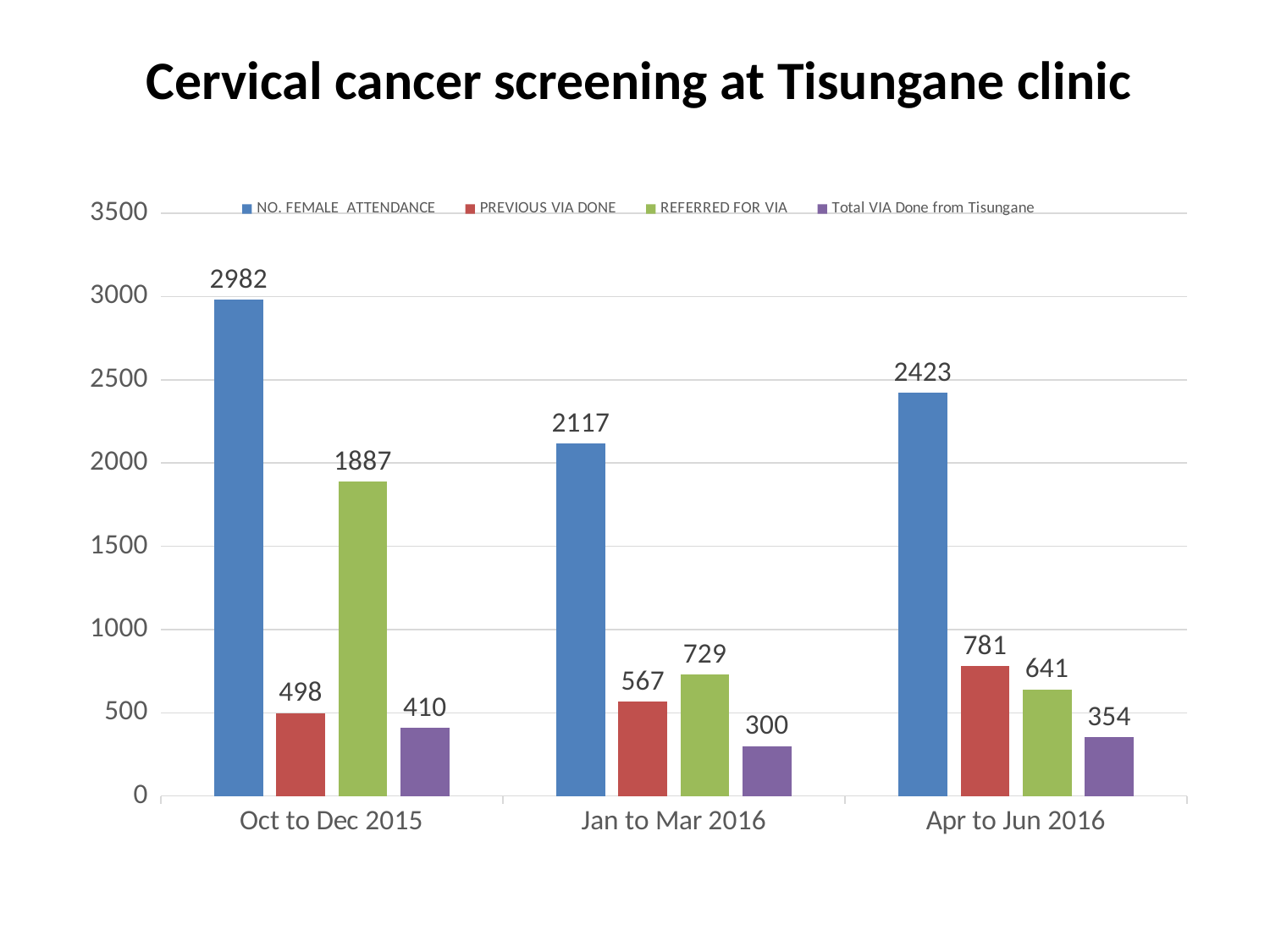
How many periods are shown on the x axis? 3 What is the Total VIA Done from Tisungane value for Apr to Jun 2016? 354 How many series does the legend list? 4 What is the difference between NO. FEMALE ATTENDANCE and REFERRED FOR VIA in Oct to Dec 2015? 1095 What is the PREVIOUS VIA DONE value for Apr to Jun 2016? 781 In which period is NO. FEMALE ATTENDANCE highest? Oct to Dec 2015 Is the REFERRED FOR VIA value for Oct to Dec 2015 greater or less than 1500? greater What kind of chart is shown on the slide? bar chart What is the NO. FEMALE ATTENDANCE value for Oct to Dec 2015? 2982 Which is larger in Apr to Jun 2016: PREVIOUS VIA DONE or REFERRED FOR VIA? PREVIOUS VIA DONE In which period is Total VIA Done from Tisungane lowest? Jan to Mar 2016 What is the REFERRED FOR VIA value for Jan to Mar 2016? 729